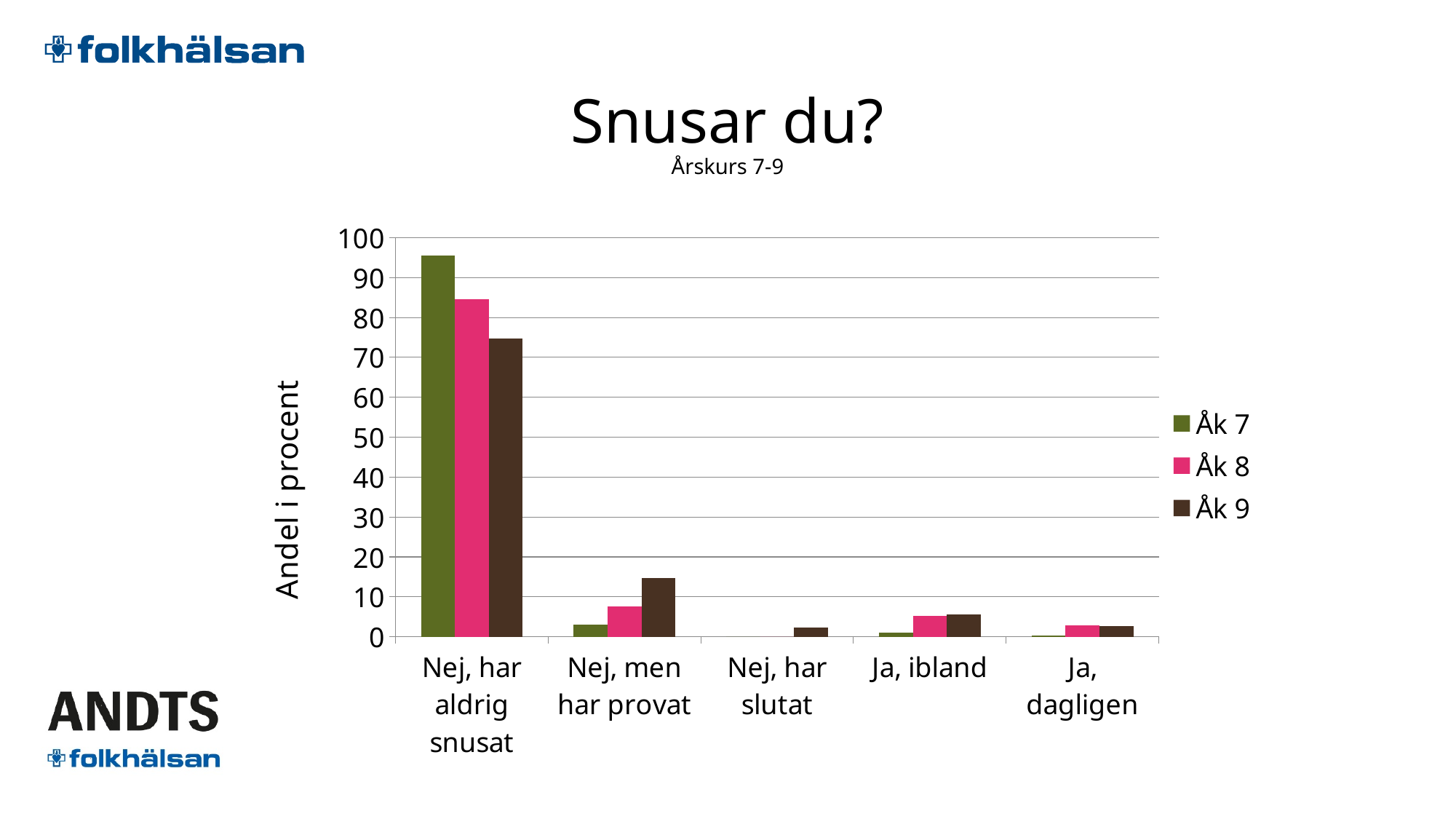
What is the label on the vertical axis of the chart? Andel i procent What kind of chart is shown on the slide? bar chart Is the value for Åk 7 in 'Nej, har aldrig snusat' greater or less than 90? greater How many series does the legend list? 3 How many answer categories are shown on the x axis? 5 In 'Nej, har aldrig snusat', which series has the larger value, Åk 7 or Åk 9? Åk 7 Is the value for Åk 9 in 'Nej, men har provat' greater or less than 10? greater Is the value for Åk 9 in 'Nej, har aldrig snusat' greater or less than 80? less For 'Nej, har aldrig snusat', do the values rise or fall from Åk 7 to Åk 9? fall In 'Nej, men har provat', which series has the larger value, Åk 7 or Åk 9? Åk 9 Which category has the highest value for Åk 7? Nej, har aldrig snusat